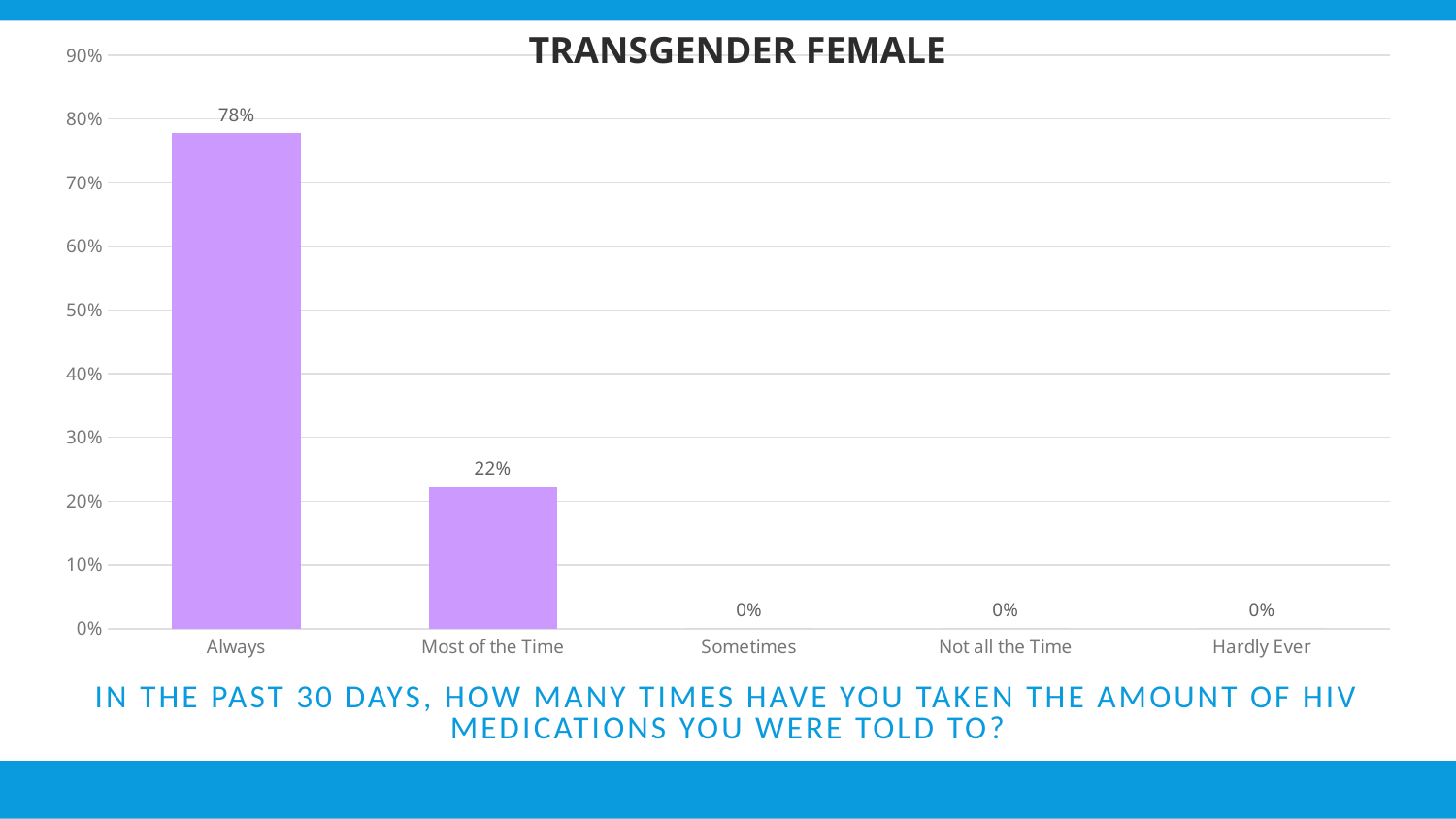
What is the difference between the values for Always and Most of the Time? 56% Which category has the highest value? Always What is the title of the chart? TRANSGENDER FEMALE Which is larger, the value for Always or the value for Most of the Time? Always Is the value for Always greater or less than 70%? greater What is the value for Most of the Time? 22% What is the value for Hardly Ever? 0% What is the total of the values for Always and Most of the Time? 100% What is the value for Always? 78% What kind of chart is shown on the slide? bar chart How many categories are shown on the x axis? 5 What is the value for Sometimes? 0%